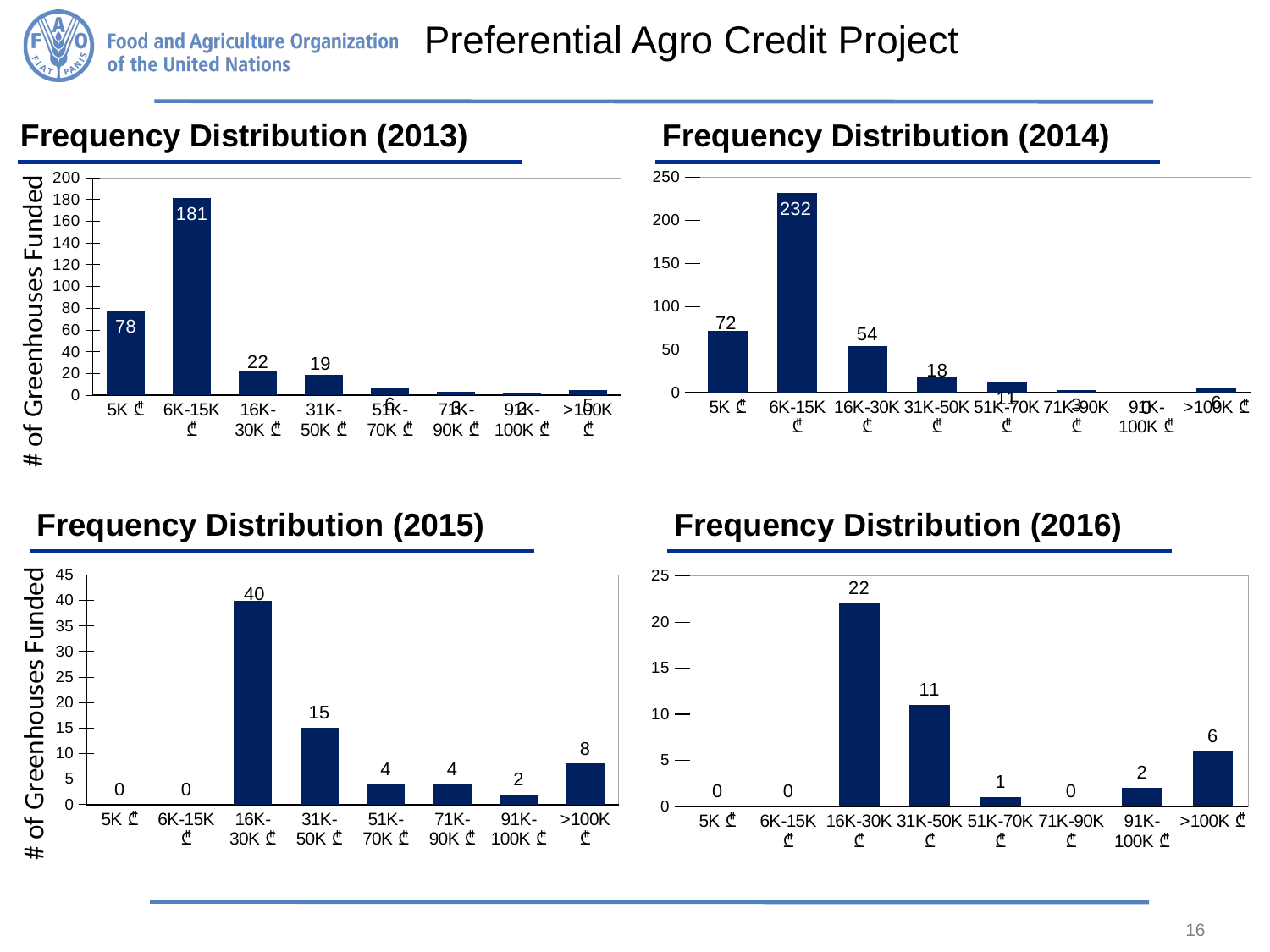
How many categories are shown on the x axis of the Frequency Distribution (2015) chart? 8 In the Frequency Distribution (2016) chart, what is the value for the >100K ₵ category? 6 In the Frequency Distribution (2015) chart, what is the difference between the 16K-30K ₵ and 31K-50K ₵ values? 25 In the Frequency Distribution (2014) chart, which category has the highest value? 6K-15K ₵ In the Frequency Distribution (2013) chart, what is the difference between the 6K-15K ₵ and 5K ₵ values? 103 In the Frequency Distribution (2013) chart, is the value for 6K-15K ₵ greater or less than 160? greater In the Frequency Distribution (2013) chart, how many greenhouses were funded in the 6K-15K ₵ category? 181 In the Frequency Distribution (2014) chart, what is the value for the 5K ₵ category? 72 In the Frequency Distribution (2014) chart, which is larger: the value for 16K-30K ₵ or the value for 31K-50K ₵? 16K-30K ₵ In the Frequency Distribution (2015) chart, what is the value for the 31K-50K ₵ category? 15 What type of chart is the Frequency Distribution (2016) chart? Bar chart In the Frequency Distribution (2016) chart, which category has the highest value? 16K-30K ₵